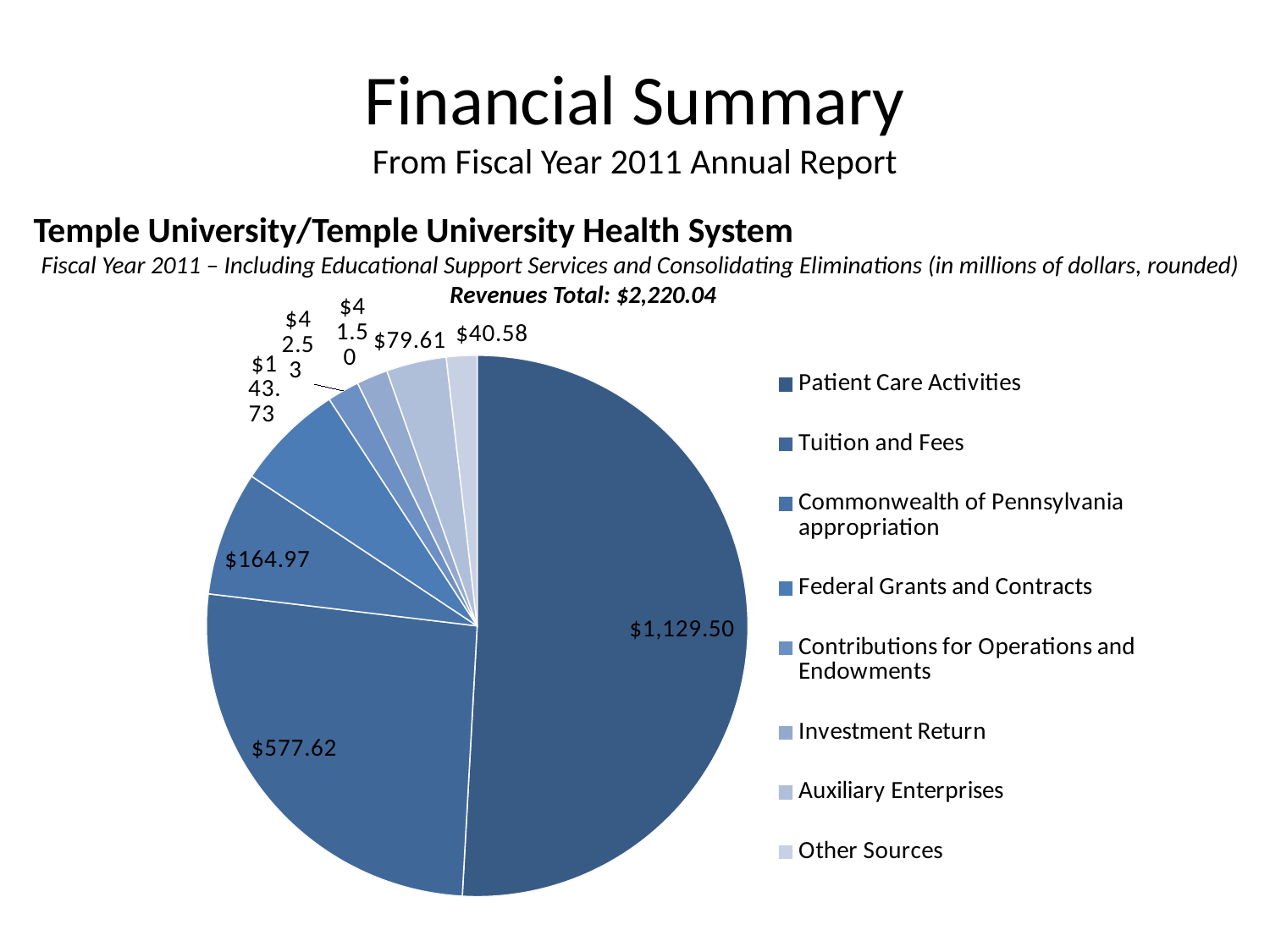
Which is larger, Auxiliary Enterprises or Contributions for Operations and Endowments? Auxiliary Enterprises Which category has the smallest slice of the pie? Other Sources Which category has the largest slice of the pie? Patient Care Activities What revenues total is printed above the pie chart? $2,220.04 How many slices does the pie chart have? 8 What type of chart is shown on the slide? Pie chart What is the value for Commonwealth of Pennsylvania appropriation? $164.97 What is the value for Tuition and Fees? $577.62 What is the value for Patient Care Activities? $1,129.50 What is the value for Auxiliary Enterprises? $79.61 What is the difference between Patient Care Activities and Tuition and Fees? $551.88 What is the last entry listed in the legend? Other Sources